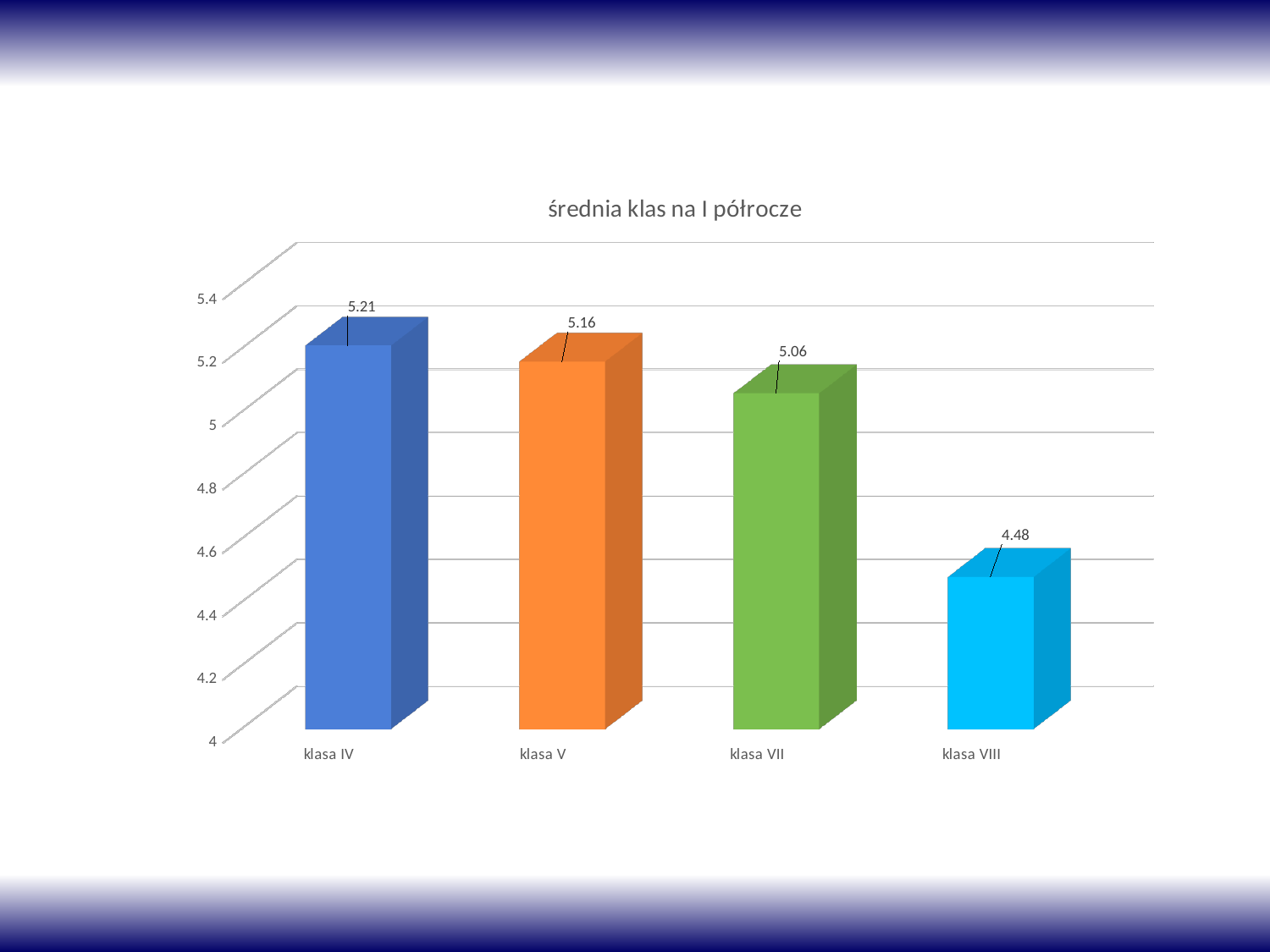
What is the title of the chart? średnia klas na I półrocze What is the value for klasa VIII? 4.48 Which is larger, the value for klasa V or the value for klasa VIII? klasa V How many categories are shown on the chart? 4 What is the difference between the values for klasa IV and klasa VIII? 0.73 Which category has the lowest value? klasa VIII What kind of chart is shown on the slide? bar chart What is the value for klasa V? 5.16 Which category has the highest value? klasa IV What is the value for klasa IV? 5.21 What is the difference between the values for klasa V and klasa VII? 0.1 What is the value for klasa VII? 5.06